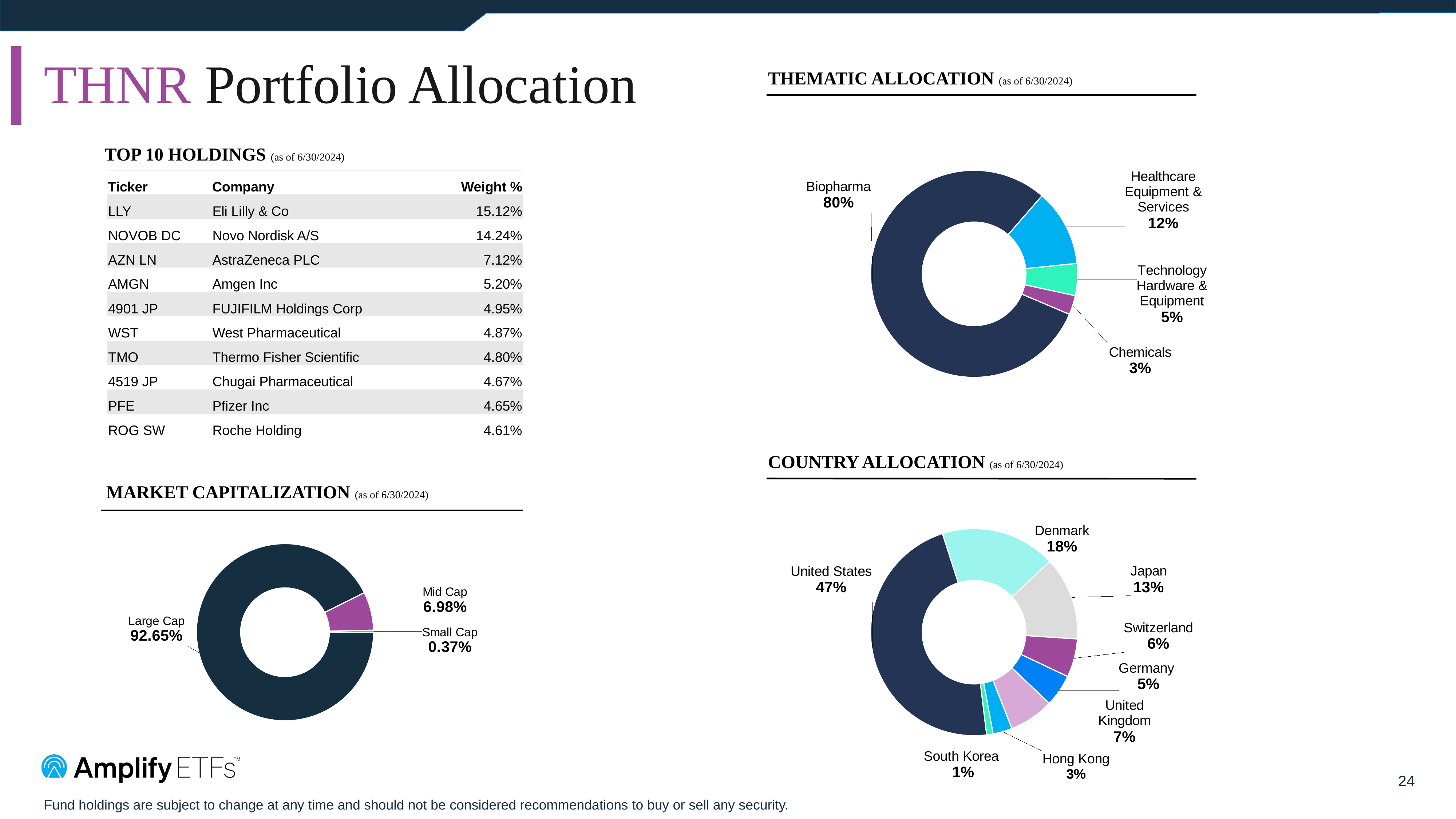
In the Thematic Allocation chart, which category is the smallest? Chemicals In the Thematic Allocation chart, what is the value for Healthcare Equipment & Services? 12% In the Thematic Allocation chart, how many categories are shown? 4 In the Country Allocation chart, how many countries are shown? 8 In the Country Allocation chart, what is the value for Japan? 13% In the Market Capitalization chart, what is the difference between Large Cap and Mid Cap? 85.67% In the Country Allocation chart, which is larger, United Kingdom or Switzerland? United Kingdom In the Country Allocation chart, which country has the largest share? United States In the Market Capitalization chart, what is the value for Small Cap? 0.37% In the Thematic Allocation chart, what is the difference between Biopharma and Technology Hardware & Equipment? 75% In the Market Capitalization chart, what is the value for Large Cap? 92.65% What kind of chart is the Country Allocation chart? Donut chart